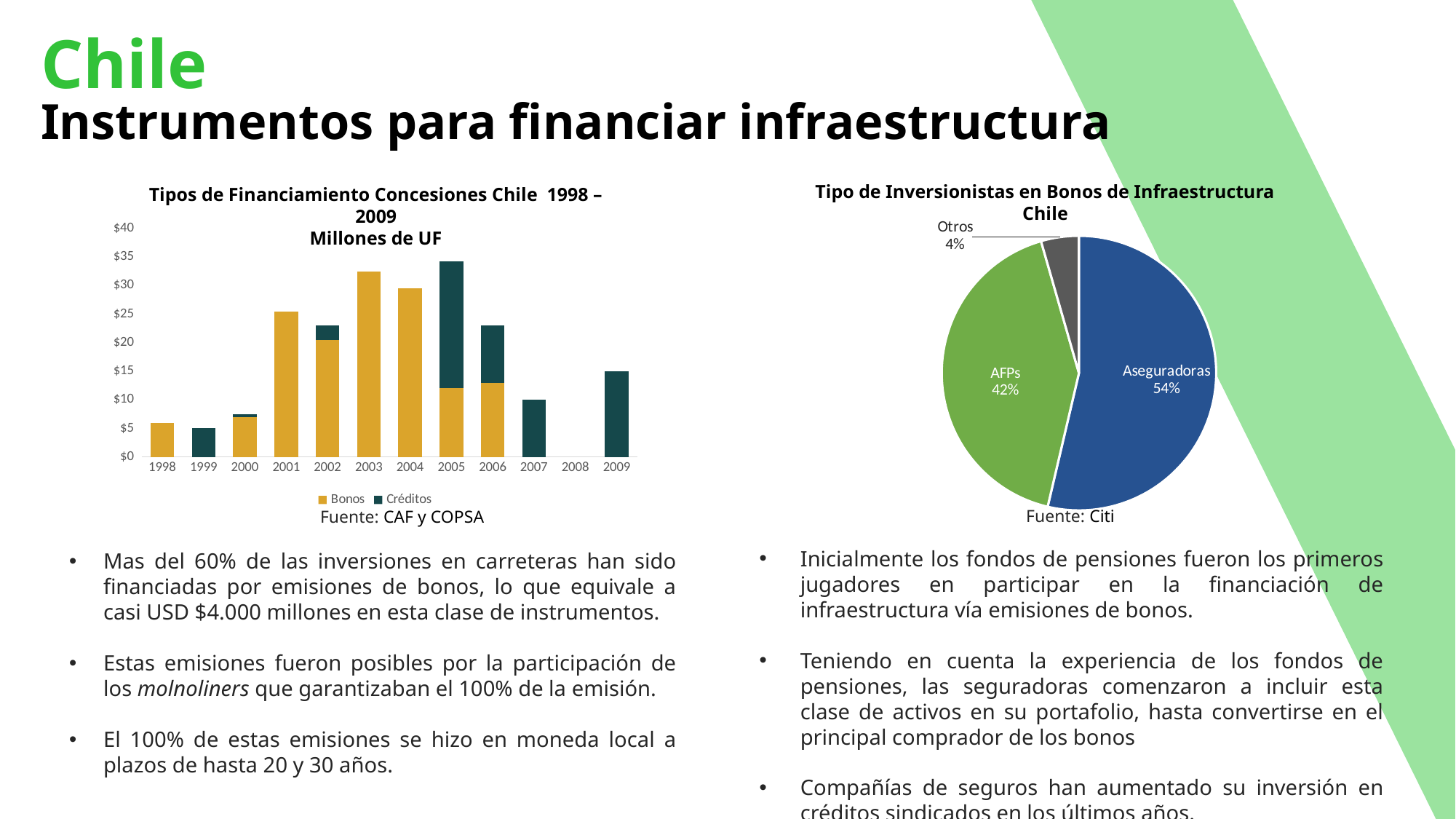
How many years are shown on the x axis of the 'Tipos de Financiamiento Concesiones Chile' chart? 12 In the 'Tipos de Financiamiento Concesiones Chile' chart, which series is shown in yellow? Bonos In the 'Tipos de Financiamiento Concesiones Chile' chart, which year has no bar at all? 2008 In the 'Tipos de Financiamiento Concesiones Chile' chart, is the value for 2007 greater or less than $15? less In the 'Tipos de Financiamiento Concesiones Chile' chart, is the total value for 2001 greater or less than $20? greater How many series does the legend of the 'Tipos de Financiamiento Concesiones Chile' chart list? 2 In the 'Tipo de Inversionistas en Bonos de Infraestructura Chile' pie chart, what share do Aseguradoras hold? 54% In the 'Tipo de Inversionistas en Bonos de Infraestructura Chile' pie chart, what is the difference between the Aseguradoras share and the AFPs share? 12 percentage points In the 'Tipo de Inversionistas en Bonos de Infraestructura Chile' pie chart, which category has the smallest share? Otros What kind of chart is 'Tipo de Inversionistas en Bonos de Infraestructura Chile'? Pie chart What kind of chart is 'Tipos de Financiamiento Concesiones Chile 1998 – 2009'? Stacked bar chart How many slices does the 'Tipo de Inversionistas en Bonos de Infraestructura Chile' pie chart have? 3